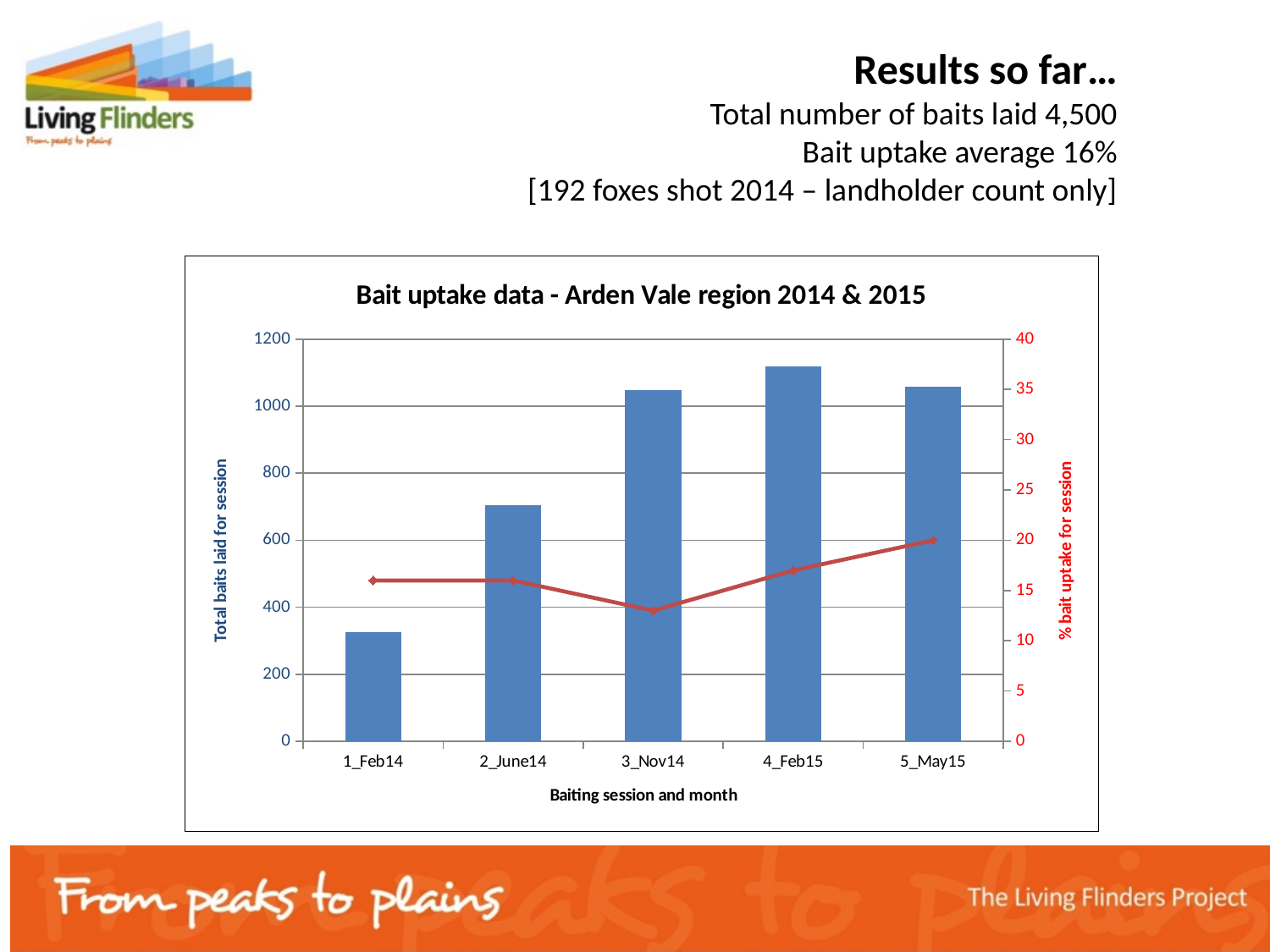
Is the total baits laid for 3_Nov14 greater or less than 1000? greater Is the total baits laid for 1_Feb14 greater or less than 400? less Do the total baits laid rise or fall from 1_Feb14 to 4_Feb15? rise Which baiting session has the highest % bait uptake? 5_May15 Which baiting session has the lowest total baits laid? 1_Feb14 How many baiting sessions are shown on the x axis? 5 What kind of chart is shown on the slide? A bar chart combined with a line Is the % bait uptake for 5_May15 greater or less than 15? greater What is the title of the chart? Bait uptake data - Arden Vale region 2014 & 2015 Which session had more total baits laid, 2_June14 or 3_Nov14? 3_Nov14 Which baiting session has the highest total baits laid? 4_Feb15 Which baiting session has the lowest % bait uptake? 3_Nov14